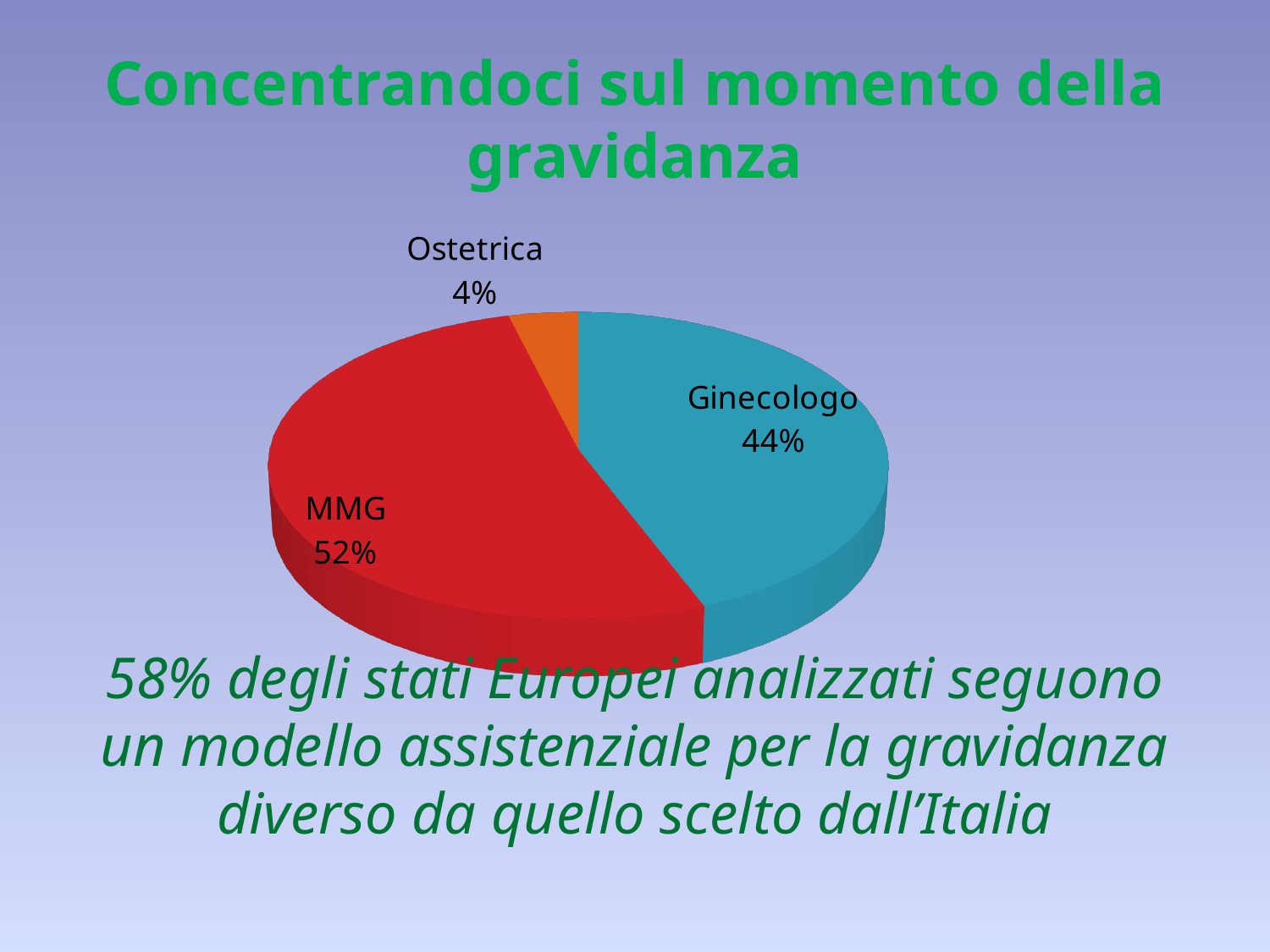
Which is larger, the share for MMG or the share for Ginecologo? MMG How many categories are shown in the pie chart? 3 What is the difference in percentage points between Ginecologo and Ostetrica? 40 Which category has the smallest slice of the pie? Ostetrica What kind of chart is shown on the slide? Pie chart What share of the pie does Ostetrica represent? 4% What colour is the slice for Ginecologo? Blue What is the title of the slide containing the chart? Concentrandoci sul momento della gravidanza What share of the pie does MMG represent? 52% Which category has the largest slice of the pie? MMG What is the difference in percentage points between MMG and Ginecologo? 8 What share of the pie does Ginecologo represent? 44%